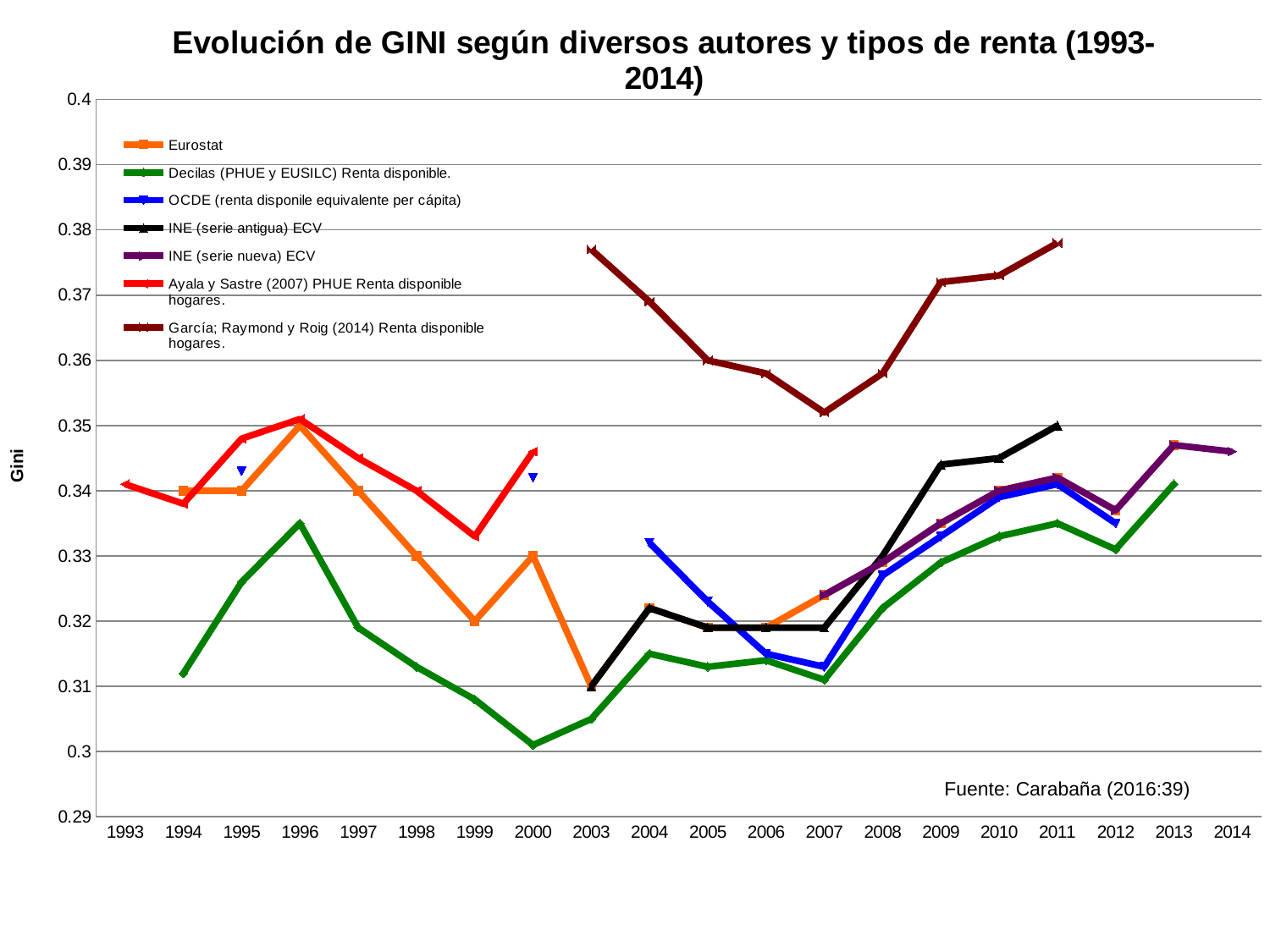
Which is larger: the García; Raymond y Roig (2014) value in 2003 or the INE (serie antigua) ECV value in 2011? García; Raymond y Roig (2014) value in 2003 Is the Decilas (PHUE y EUSILC) value for 2000 greater or less than 0.31? less Is the García; Raymond y Roig (2014) value for 2007 greater or less than 0.36? less How many years are shown on the x axis? 20 Which series has the highest values on the chart? García; Raymond y Roig (2014) Renta disponible hogares. How many series does the legend list? 7 In which year does the Decilas (PHUE y EUSILC) series reach its lowest value? 2000 What is the INE (serie antigua) ECV value in 2011? 0.35 What is the García; Raymond y Roig (2014) value in 2005? 0.36 What kind of chart is shown on the slide? line chart Does the García; Raymond y Roig (2014) series rise or fall from 2007 to 2011? rise What is the Eurostat value in 1996? 0.35